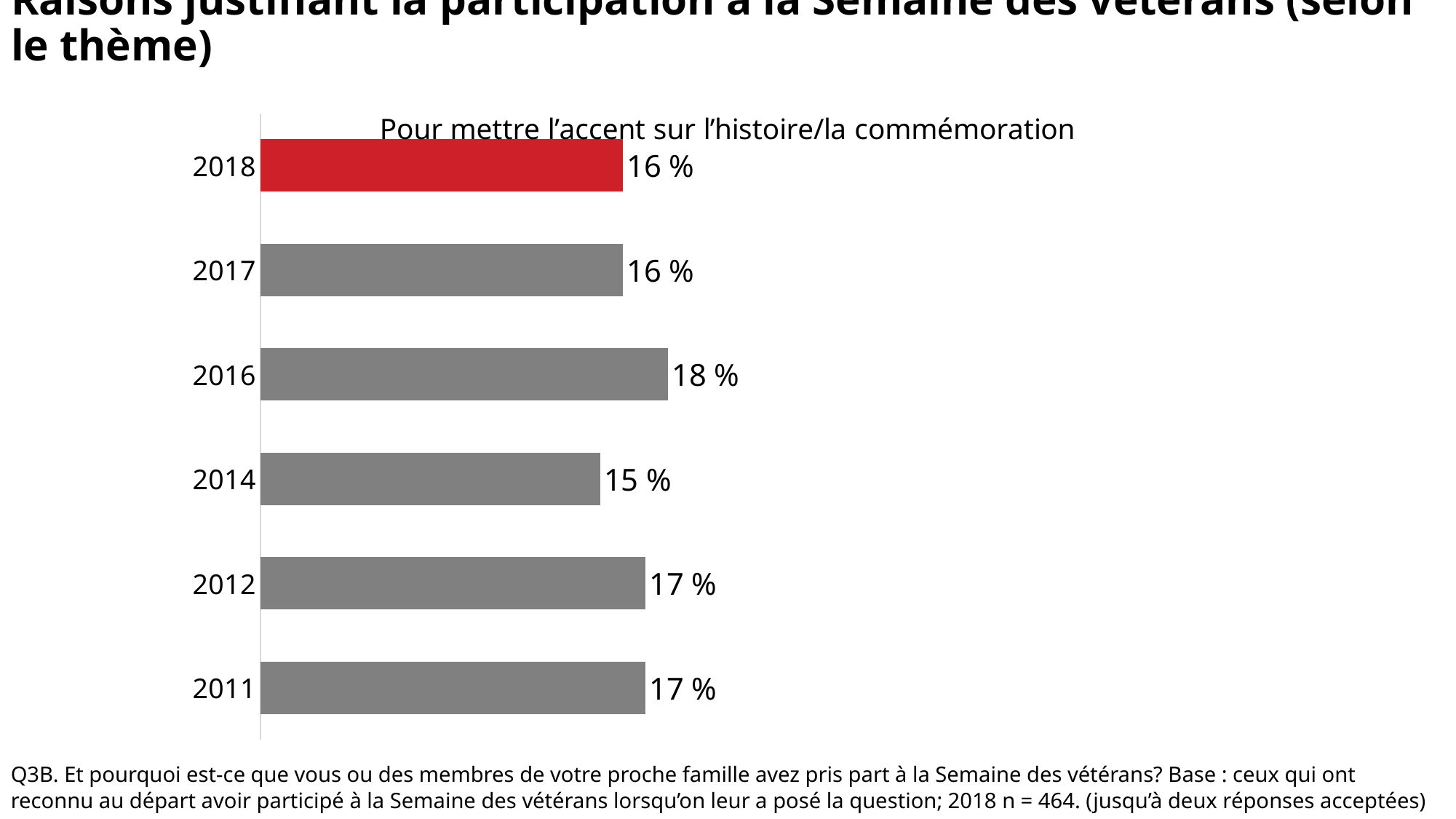
What is the title of the chart? Pour mettre l'accent sur l'histoire/la commémoration What is the value for 2011? 17 % What kind of chart is shown on the slide? Bar chart What is the value for 2018? 16 % Which year has the highest value? 2016 Which is larger, the value for 2012 or the value for 2018? 2012 What is the difference between the values for 2016 and 2014? 3 % How many years are shown in the chart? 6 Which year has the lowest value? 2014 What is the value for 2016? 18 % What is the value for 2014? 15 % Which year's bar is coloured red? 2018